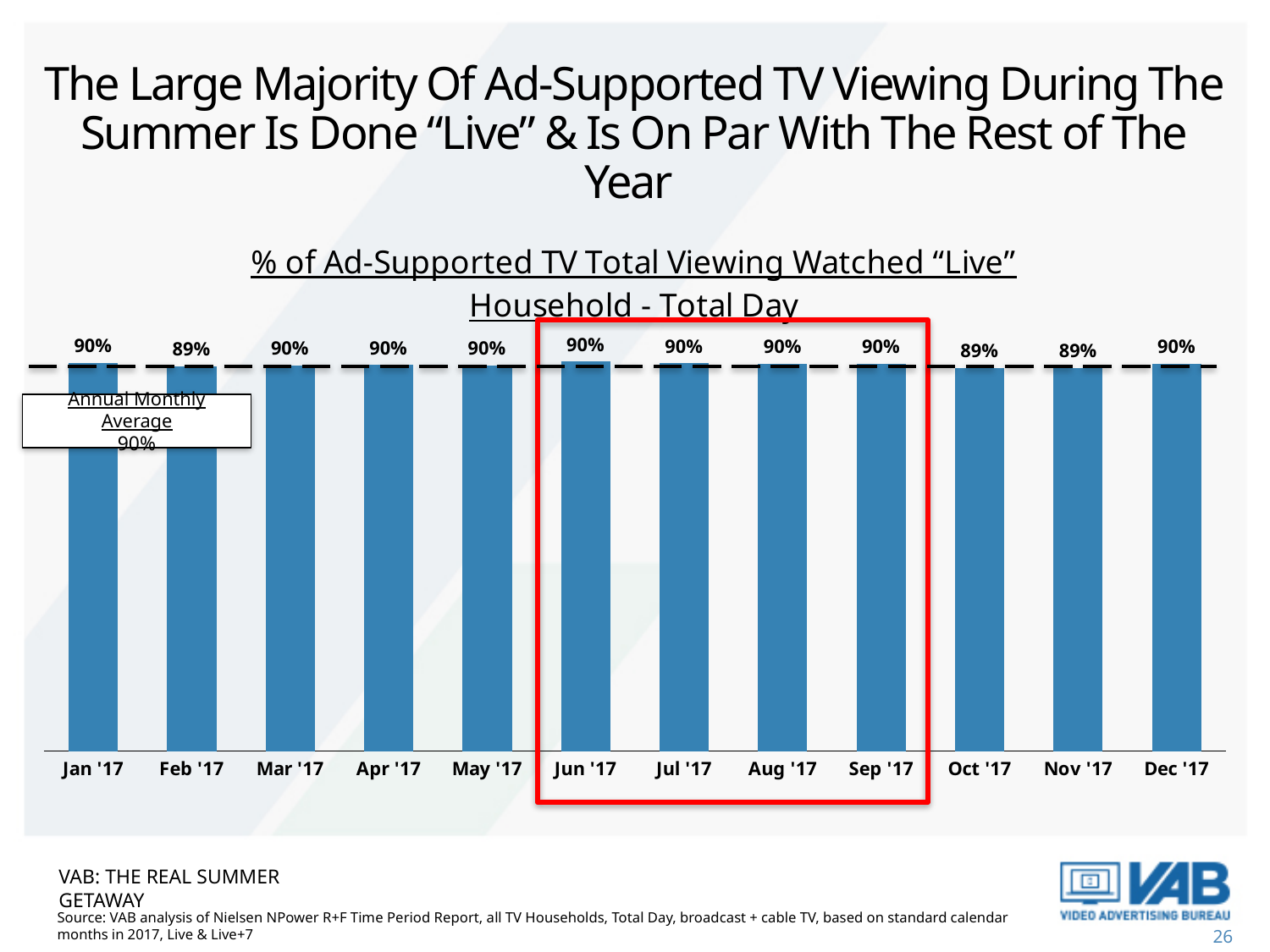
What is the value for Aug '17? 90% What is the value for Dec '17? 90% What is the annual monthly average shown by the dashed line? 90% What is the difference between the values for Jan '17 and Feb '17? 1 percentage point Which months are enclosed by the red box on the chart? Jun '17 through Sep '17 Which is larger, the value for Sep '17 or the value for Oct '17? Sep '17 How many months are shown on the x axis? 12 What kind of chart is this? Bar chart What is the value for Nov '17? 89% What is the value for Jan '17? 90% What is the value for Feb '17? 89% How many months have a value of 89%? 3